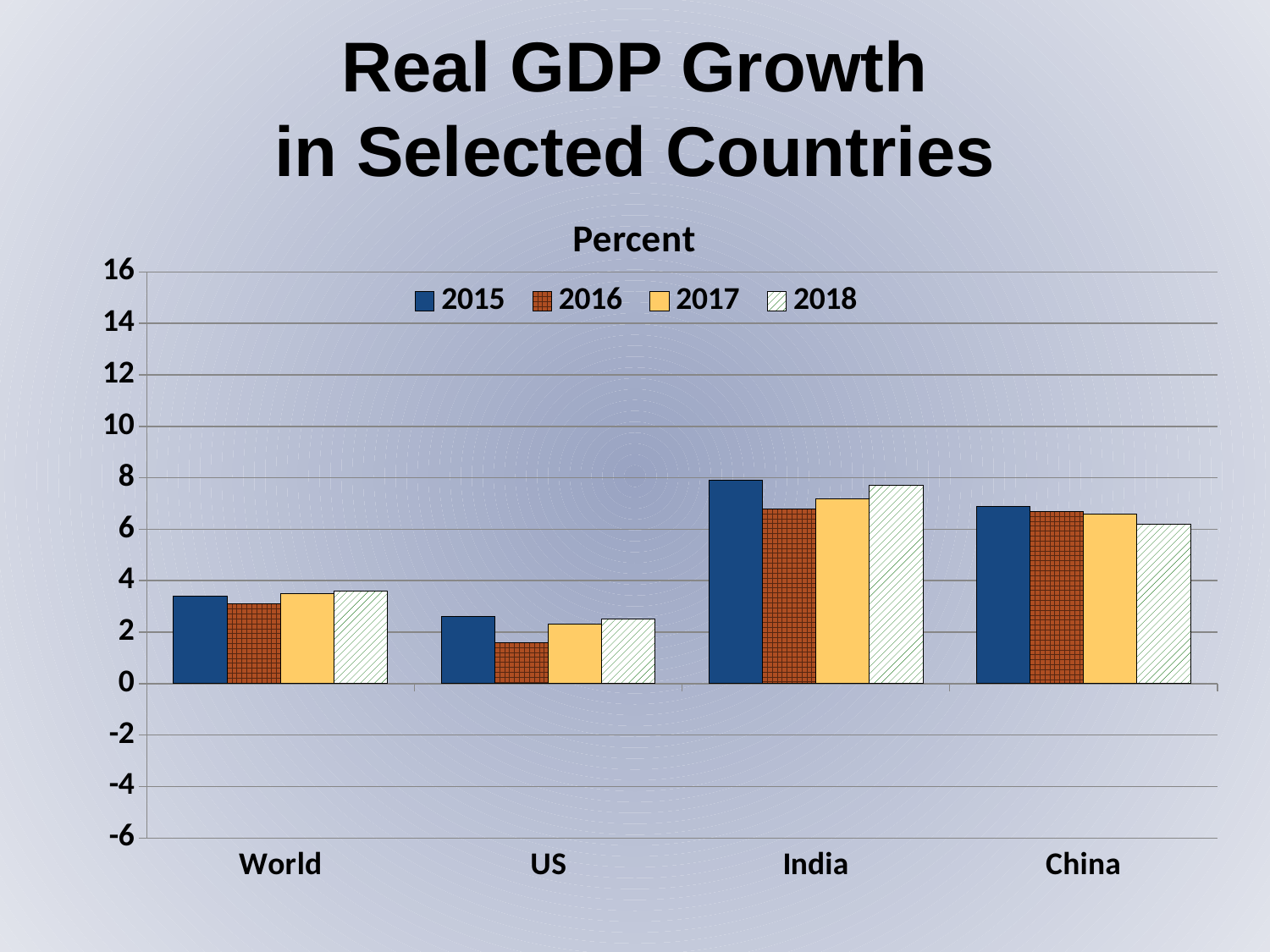
Is the 2015 value for India greater or less than 6? greater How many countries/regions are shown on the x axis? 4 Which is larger, the 2016 value for World or the 2016 value for US? World Do the values for China rise or fall from 2015 to 2018? fall What are the four years listed in the legend? 2015, 2016, 2017, 2018 What kind of chart is shown on the slide? bar chart Is the 2016 value for US greater or less than 2? less How many series does the legend list? 4 Which is larger, the 2015 value for India or the 2015 value for China? India Is the 2018 value for China greater or less than 8? less Which country or region has the lowest real GDP growth in 2016? US Which country or region has the highest real GDP growth in 2015? India